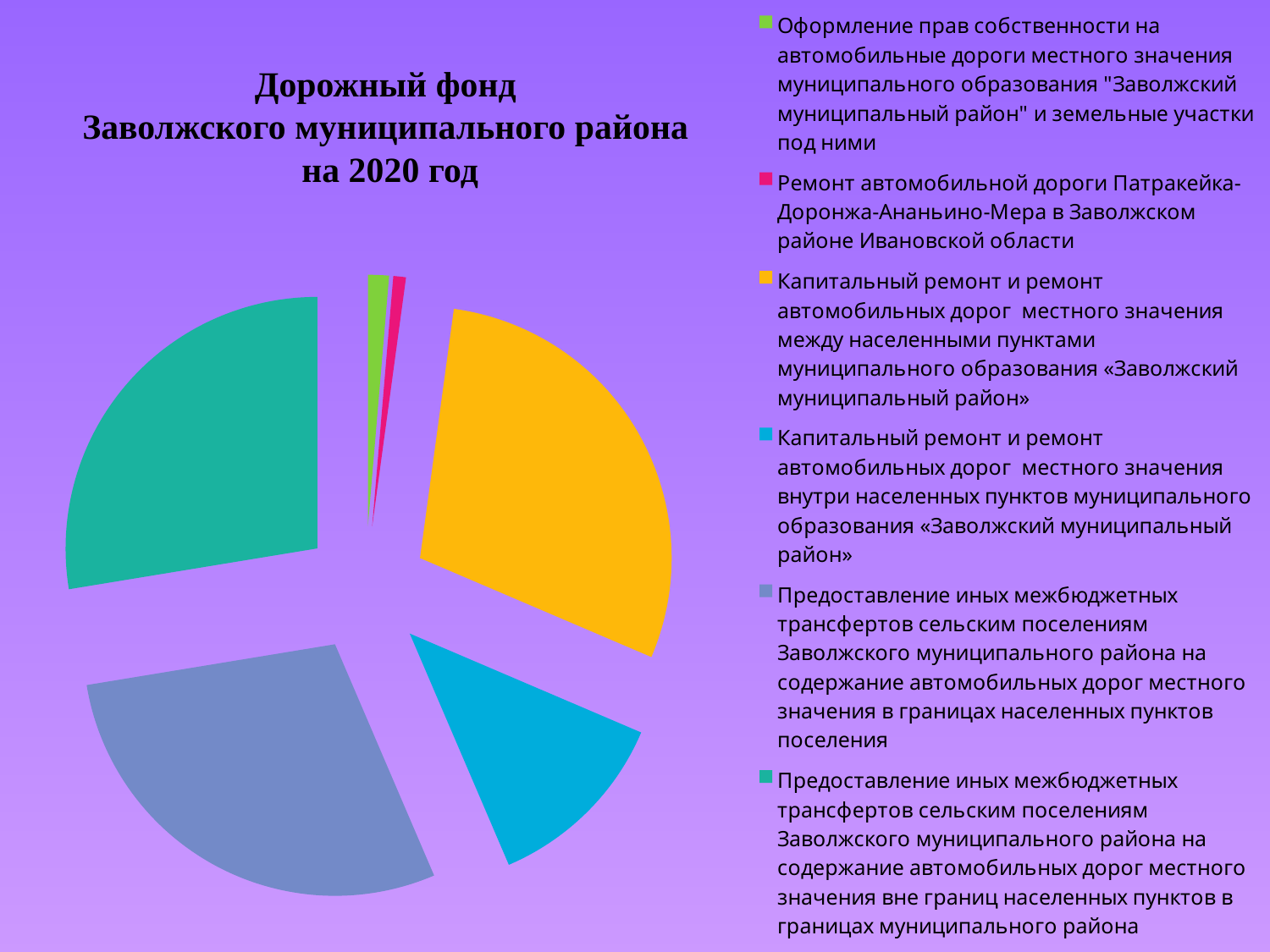
Which slice is larger: "Ремонт автомобильной дороги Патракейка-Доронжа-Ананьино-Мера в Заволжском районе Ивановской области" or "Предоставление иных межбюджетных трансфертов сельским поселениям ... вне границ населенных пунктов в границах муниципального района"? Предоставление иных межбюджетных трансфертов сельским поселениям ... вне границ населенных пунктов в границах муниципального района How many categories does the legend of the pie chart list? 6 Which slice is larger: "Капитальный ремонт и ремонт автомобильных дорог местного значения между населенными пунктами муниципального образования «Заволжский муниципальный район»" or "Капитальный ремонт и ремонт автомобильных дорог местного значения внутри населенных пунктов муниципального образования «Заволжский муниципальный район»"? Капитальный ремонт и ремонт автомобильных дорог местного значения между населенными пунктами муниципального образования «Заволжский муниципальный район» What colour is the slice for "Ремонт автомобильной дороги Патракейка-Доронжа-Ананьино-Мера в Заволжском районе Ивановской области"? pink What kind of chart is shown on the slide? pie chart What is the title of the chart? Дорожный фонд Заволжского муниципального района на 2020 год Which slice is larger: "Оформление прав собственности на автомобильные дороги местного значения..." or "Предоставление иных межбюджетных трансфертов сельским поселениям ... в границах населенных пунктов поселения"? Предоставление иных межбюджетных трансфертов сельским поселениям ... в границах населенных пунктов поселения